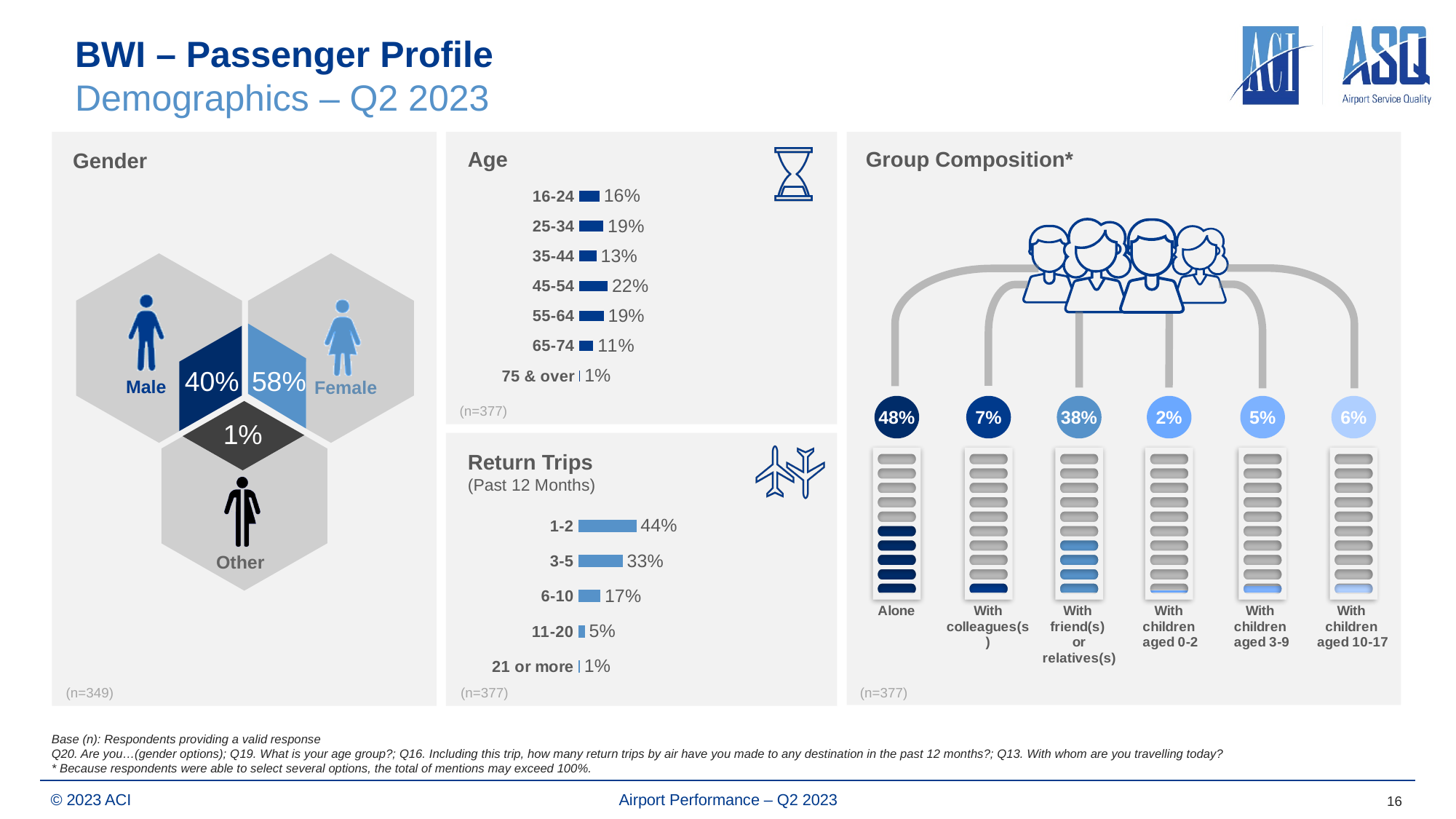
In the Age chart, which age group has the lowest percentage? 75 & over In the Return Trips chart, which is larger: 6-10 or 11-20? 6-10 In the Age chart, what percentage of passengers are aged 45-54? 22% In the Return Trips chart, what is the difference between the 1-2 and 3-5 categories? 11% In the Group Composition chart, which category has the lowest percentage? With children aged 0-2 In the Gender chart, what percentage of passengers are Female? 58% What kind of chart is the Return Trips chart? Bar chart In the Age chart, which age group has the highest percentage? 45-54 In the Group Composition chart, what percentage of passengers travel alone? 48% In the Gender chart, what is the difference between Female and Male? 18% In the Return Trips chart, what percentage of passengers made 1-2 return trips? 44% In the Age chart, how many age groups are shown? 7